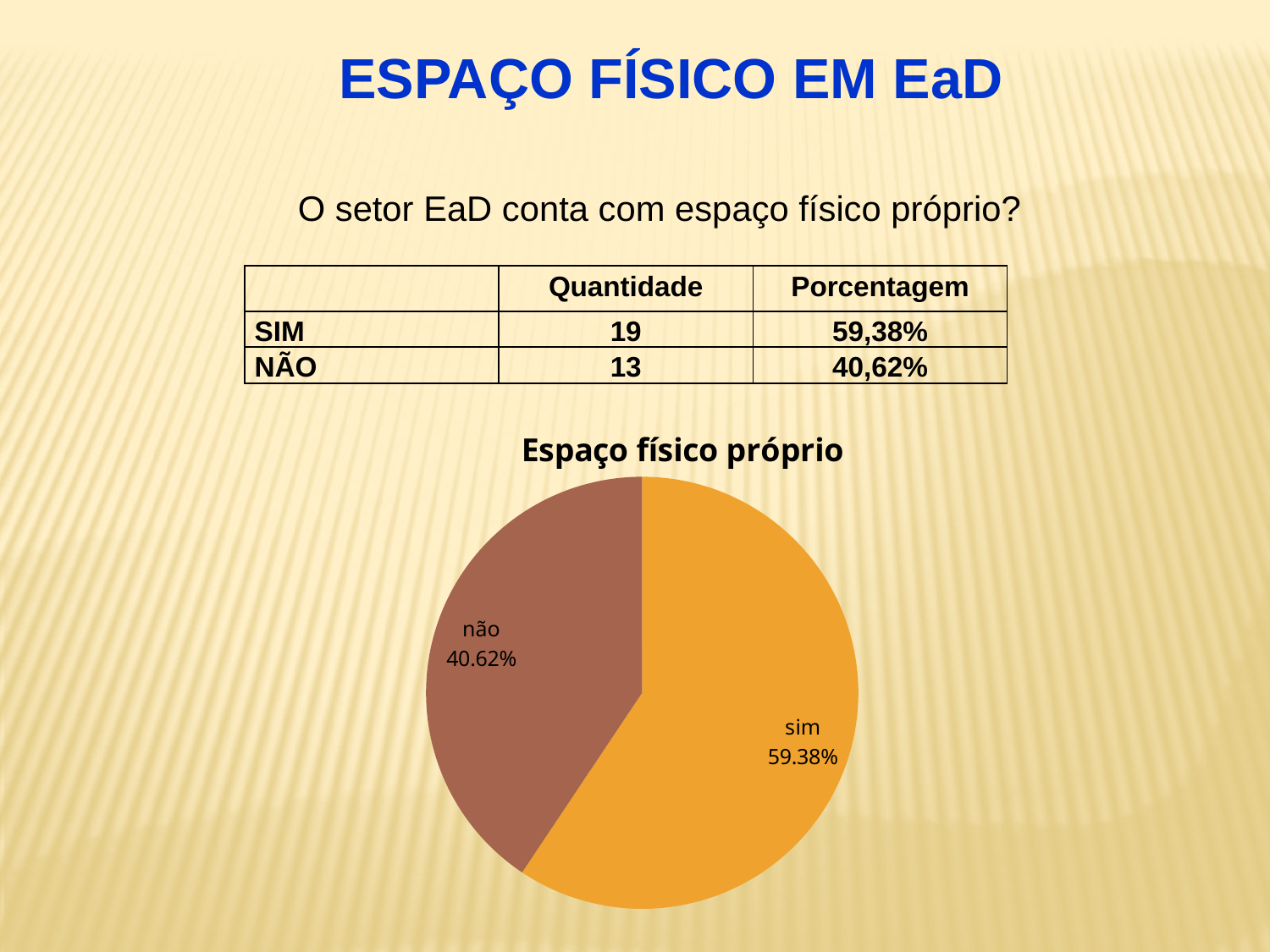
Which slice is larger, "sim" or "não"? sim Which slice of the pie is the largest? sim What is the difference in percentage points between the "sim" and "não" slices? 18.76% What is the title of the chart? Espaço físico próprio What colour is the "sim" slice of the pie? orange How many slices does the pie chart have? 2 What kind of chart is shown on the slide? pie chart What share of the pie does the "sim" slice represent? 59.38% Is the share of the "sim" slice greater or less than 50%? greater Which slice of the pie is the smallest? não What share of the pie does the "não" slice represent? 40.62%